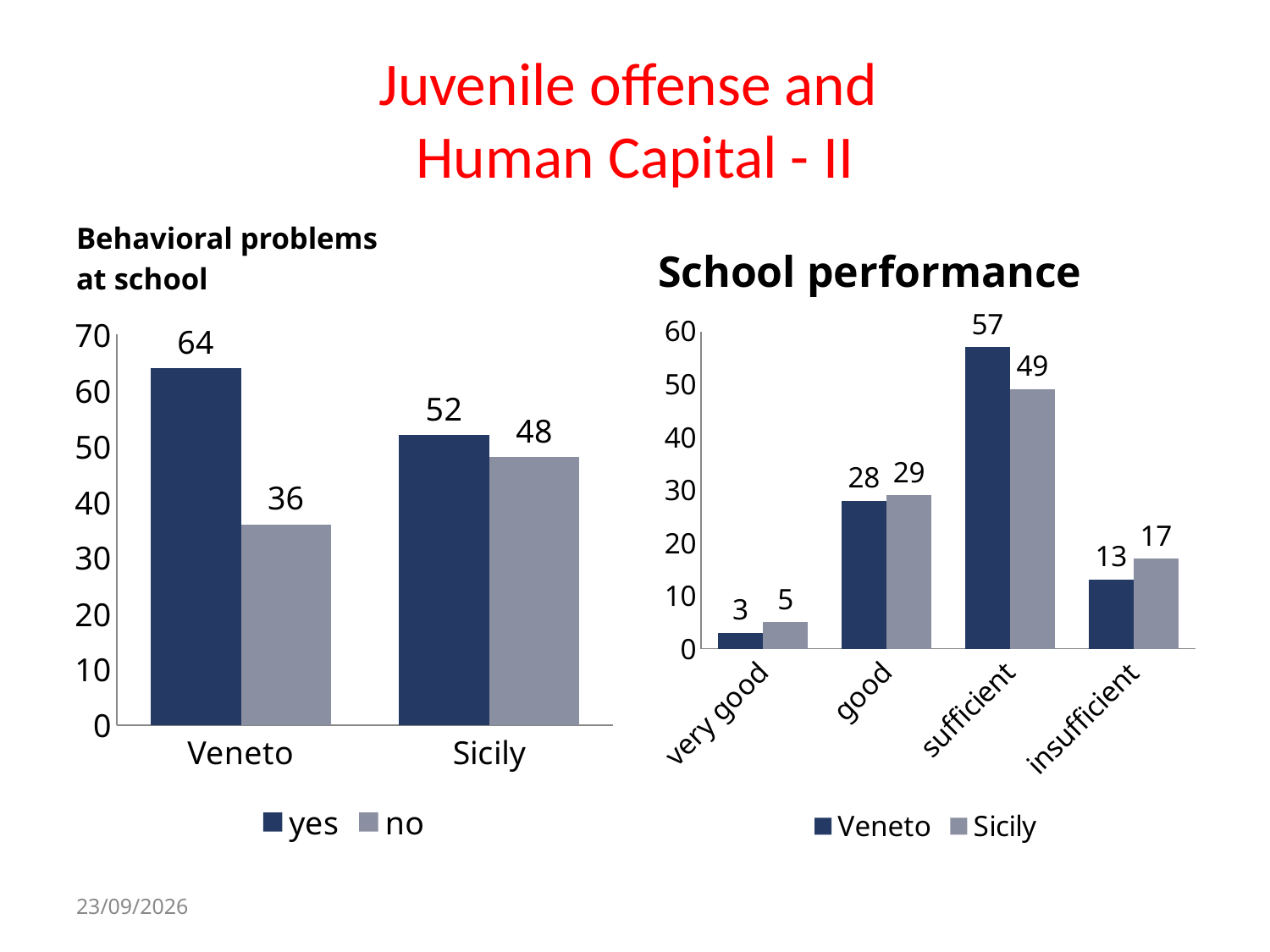
In the 'Behavioral problems at school' chart, what is the value for 'no' in Sicily? 48 In the 'Behavioral problems at school' chart, what is the value for 'yes' in Veneto? 64 In the 'School performance' chart, what is the Veneto value for 'sufficient'? 57 In the 'School performance' chart, how many categories are shown on the x axis? 4 What kind of chart is the 'School performance' chart? Bar chart In the 'Behavioral problems at school' chart, what is the difference between 'yes' and 'no' for Veneto? 28 In the 'School performance' chart, which category has the highest Sicily value? sufficient In the 'School performance' chart, what is the Sicily value for 'insufficient'? 17 In the 'School performance' chart, what is the difference between Veneto and Sicily for 'sufficient'? 8 In the 'Behavioral problems at school' chart, how many series does the legend list? 2 In the 'Behavioral problems at school' chart, which region has the higher 'no' value? Sicily In the 'School performance' chart, which category has the lowest Veneto value? very good